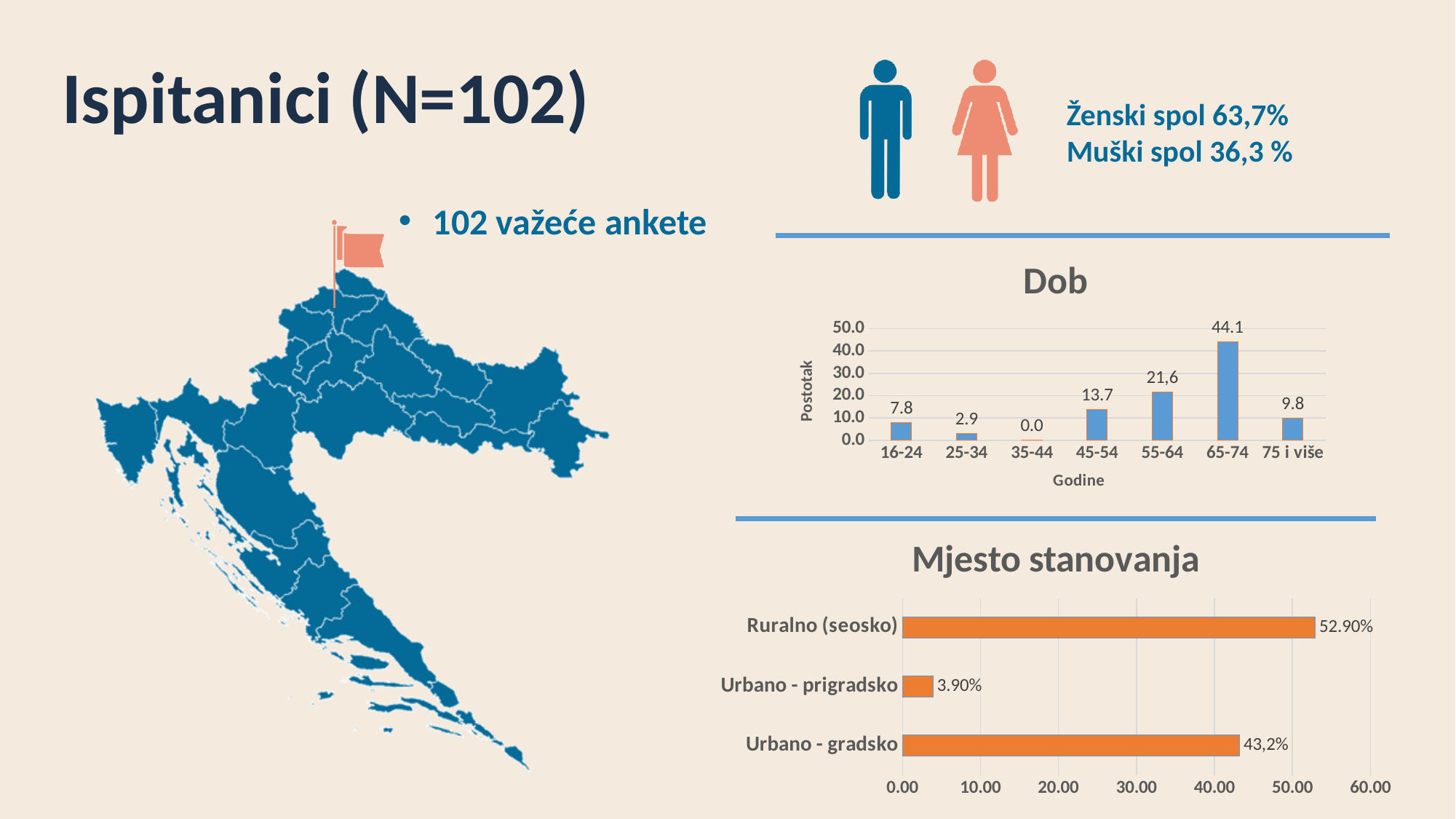
In the "Dob" chart, which age group has the lowest value? 35-44 In the "Dob" chart, what is the value for the 65-74 age group? 44.1 In the "Mjesto stanovanja" chart, what is the value for Urbano - prigradsko? 3.90% What kind of chart is the "Dob" chart? Bar chart In the "Dob" chart, how many age groups are shown on the x axis? 7 In the "Dob" chart, which is larger, the value for 45-54 or the value for 75 i više? 45-54 In the "Mjesto stanovanja" chart, which category has the lowest value? Urbano - prigradsko In the "Dob" chart, what is the difference between the values for 65-74 and 55-64? 22.5 In the "Mjesto stanovanja" chart, what is the value for Ruralno (seosko)? 52.90% In the "Dob" chart, which age group has the highest value? 65-74 In the "Dob" chart, what is the value for the 16-24 age group? 7.8 In the "Mjesto stanovanja" chart, is the value for Urbano - gradsko greater or less than 40.00? greater